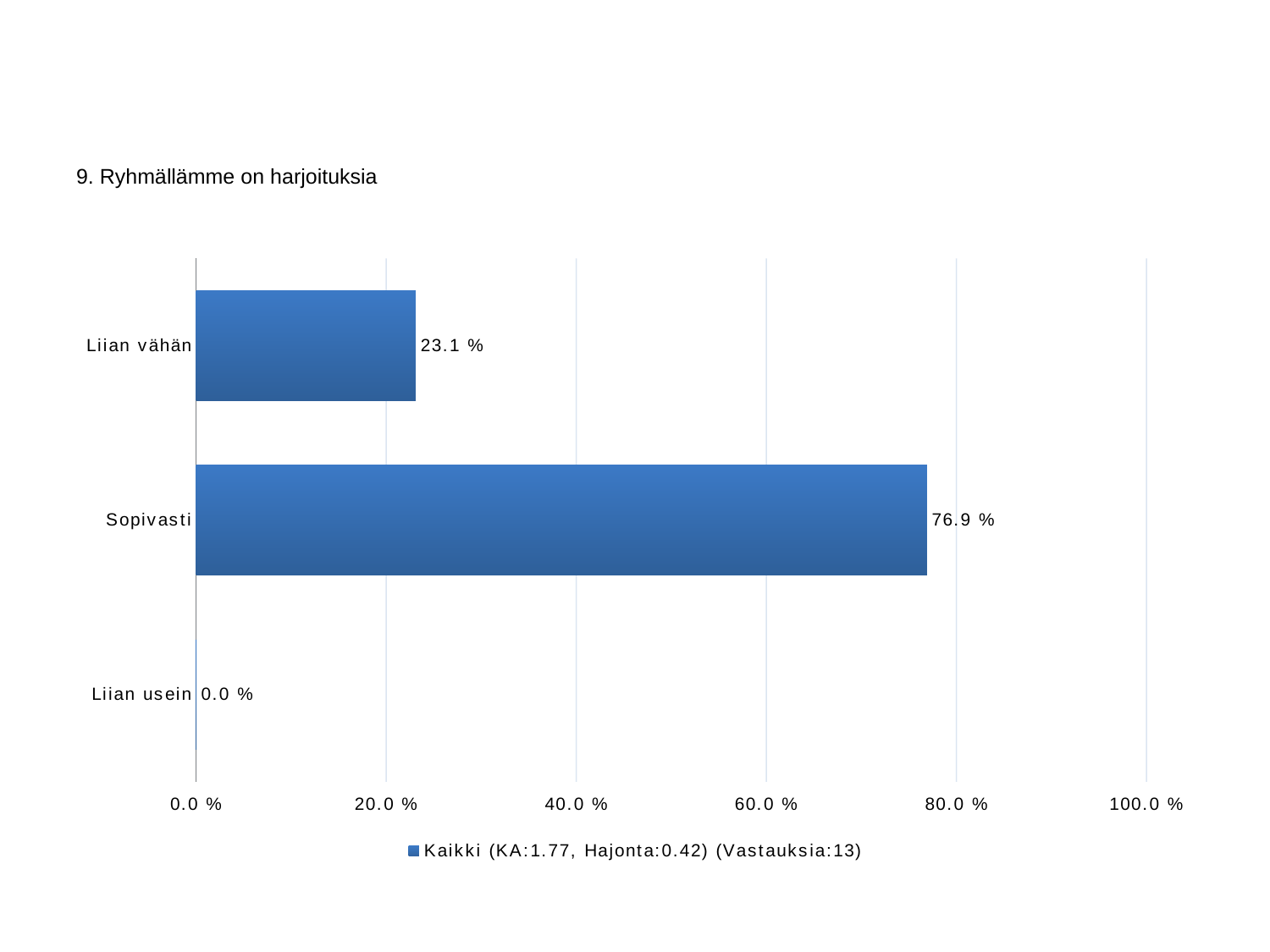
Which is larger, the value for Liian vähän or the value for Sopivasti? Sopivasti Which category has the highest value? Sopivasti What is the value for Liian vähän? 23.1 % What kind of chart is shown on the slide? bar chart Is the value for Sopivasti greater or less than 60.0 %? greater What is the value for Sopivasti? 76.9 % How many categories are shown on the chart? 3 Is the value for Liian vähän greater or less than 40.0 %? less What is the value for Liian usein? 0.0 % What is the title of the chart? 9. Ryhmällämme on harjoituksia Which category has the lowest value? Liian usein What is the difference between the values for Sopivasti and Liian vähän? 53.8 %